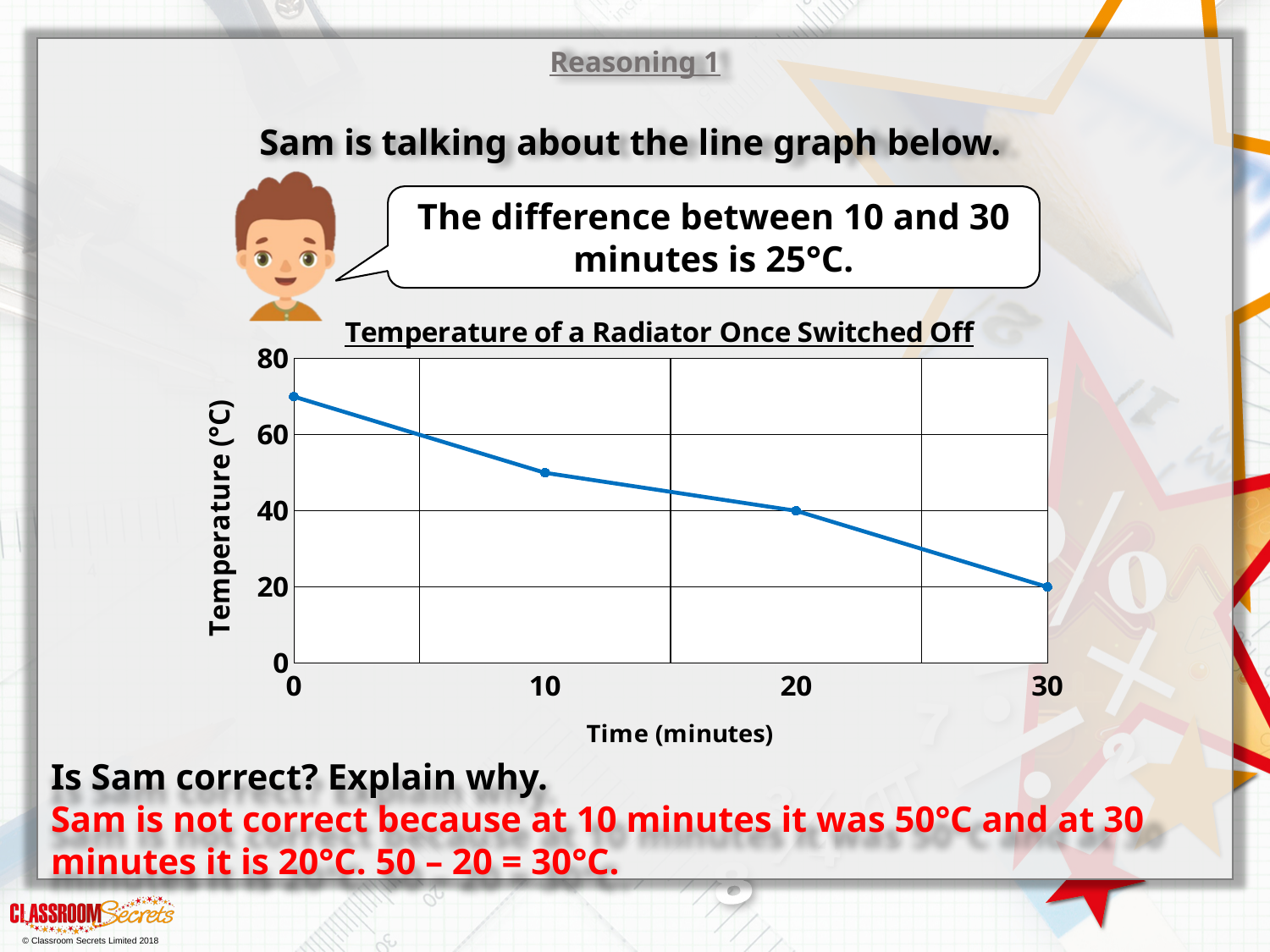
Is the temperature at 10 minutes greater or less than 60? less At which time is the temperature lowest? 30 minutes What is the temperature at 30 minutes? 20 What is the difference in temperature between 10 minutes and 30 minutes? 30°C What kind of chart is shown on the slide? line chart Does the temperature rise or fall as time increases? fall Is the temperature at 0 minutes greater or less than 60? greater What is the temperature at 20 minutes? 40 What is the title of the chart? Temperature of a Radiator Once Switched Off What is the difference in temperature between 20 minutes and 30 minutes? 20 What is the temperature at 10 minutes? 50°C At which time is the temperature highest? 0 minutes